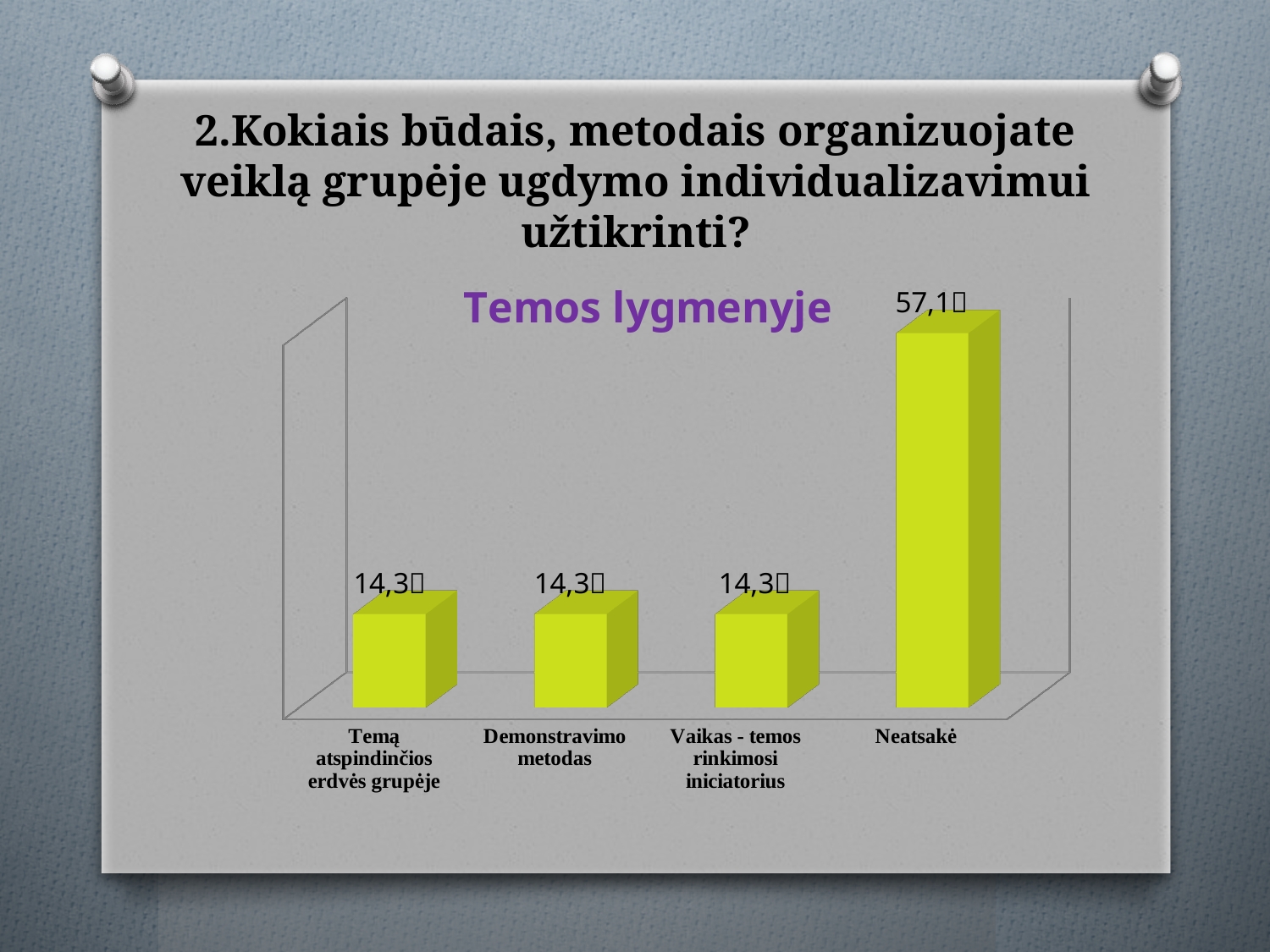
How many categories are shown in the chart? 4 Which category has the highest value? Neatsakė What colour are the bars in the chart? Yellow-green What is the value for Temą atspindinčios erdvės grupėje? 14,3 What is the value for Neatsakė? 57,1 What is the value for Vaikas - temos rinkimosi iniciatorius? 14,3 What kind of chart is shown on the slide? Bar chart What is the value for Demonstravimo metodas? 14,3 How many categories share the value 14,3? 3 What is the difference between the value for Neatsakė and the value for Demonstravimo metodas? 42,8 What is the title of the chart? Temos lygmenyje Which is larger, the value for Neatsakė or the value for Vaikas - temos rinkimosi iniciatorius? Neatsakė